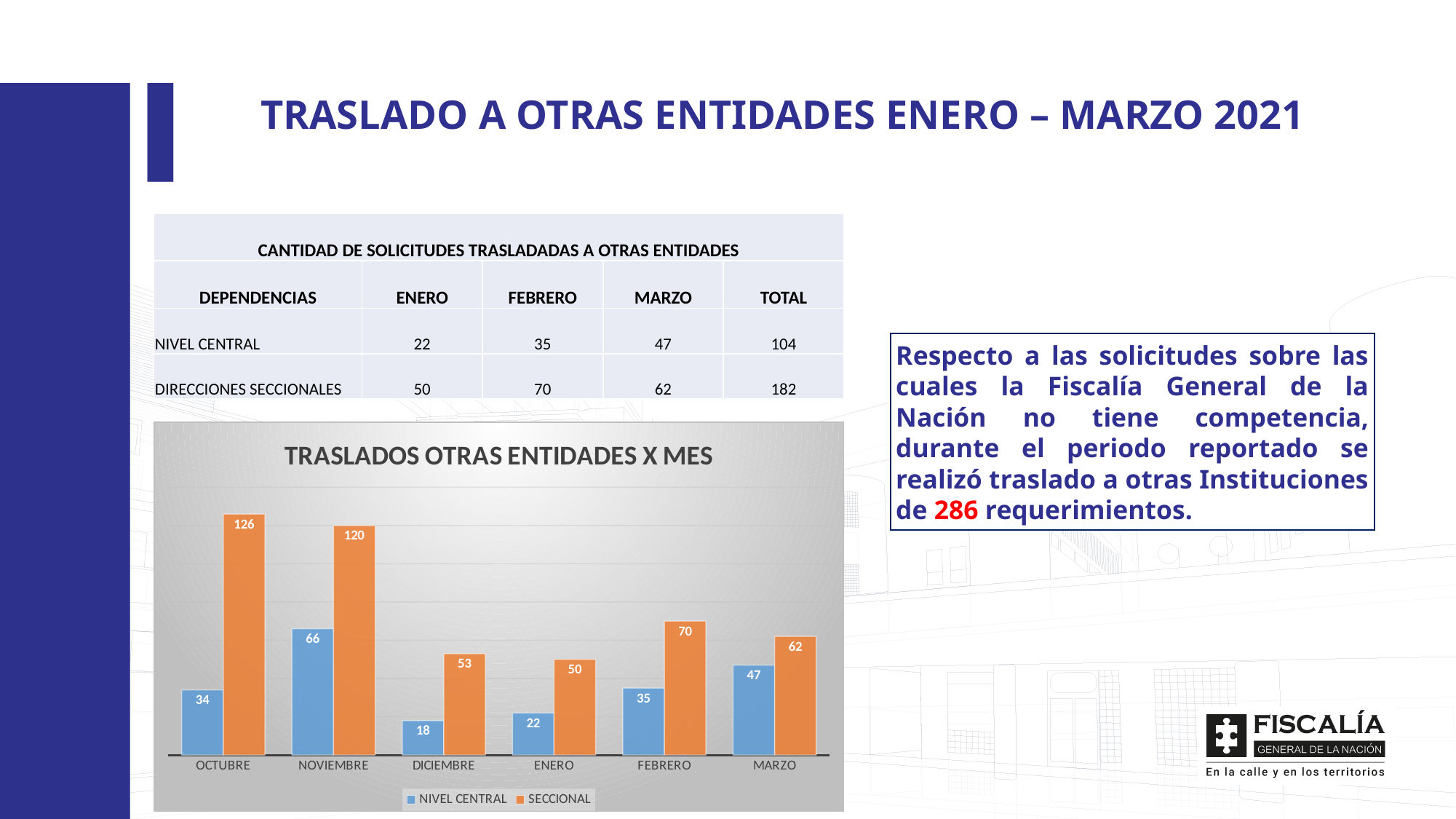
What kind of chart is shown on the slide? Bar chart What is the difference between the SECCIONAL and NIVEL CENTRAL values in FEBRERO? 35 Which month has the highest SECCIONAL value? OCTUBRE How many series does the chart legend list? 2 Does the NIVEL CENTRAL value rise or fall from DICIEMBRE to MARZO? Rise What is the title of the chart? TRASLADOS OTRAS ENTIDADES X MES Which month has the lowest NIVEL CENTRAL value? DICIEMBRE What is the value for SECCIONAL in MARZO? 62 How many months are shown on the x axis of the chart? 6 What is the value for SECCIONAL in NOVIEMBRE? 120 Which is larger in NOVIEMBRE, NIVEL CENTRAL or SECCIONAL? SECCIONAL What is the value for NIVEL CENTRAL in OCTUBRE? 34